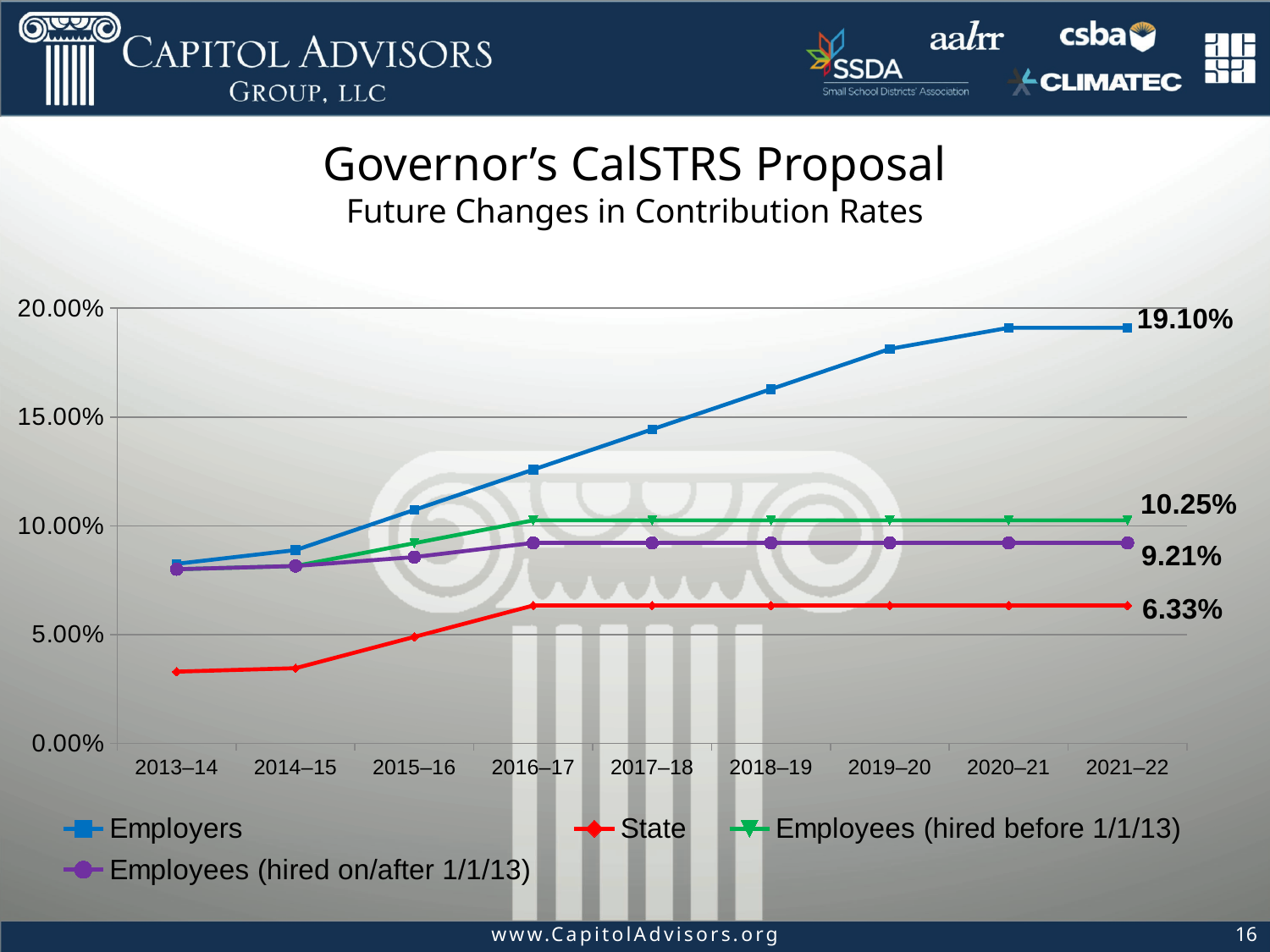
Which series has the lowest contribution rate in 2021–22? State How many series does the legend list? 4 Is the Employers contribution rate in 2013–14 greater or less than 10.00%? less Which series has the highest contribution rate in 2021–22? Employers What is the contribution rate for Employees (hired before 1/1/13) in 2021–22? 10.25% What is the Employers contribution rate in 2021–22? 19.10% What type of chart is shown on the slide? line chart What is the difference between the Employers rate and the State rate in 2021–22? 12.77% Does the Employers contribution rate rise or fall from 2013–14 to 2021–22? rise What is the contribution rate for Employees (hired on/after 1/1/13) in 2021–22? 9.21% What is the State contribution rate in 2021–22? 6.33% How many fiscal years are shown on the x axis? 9